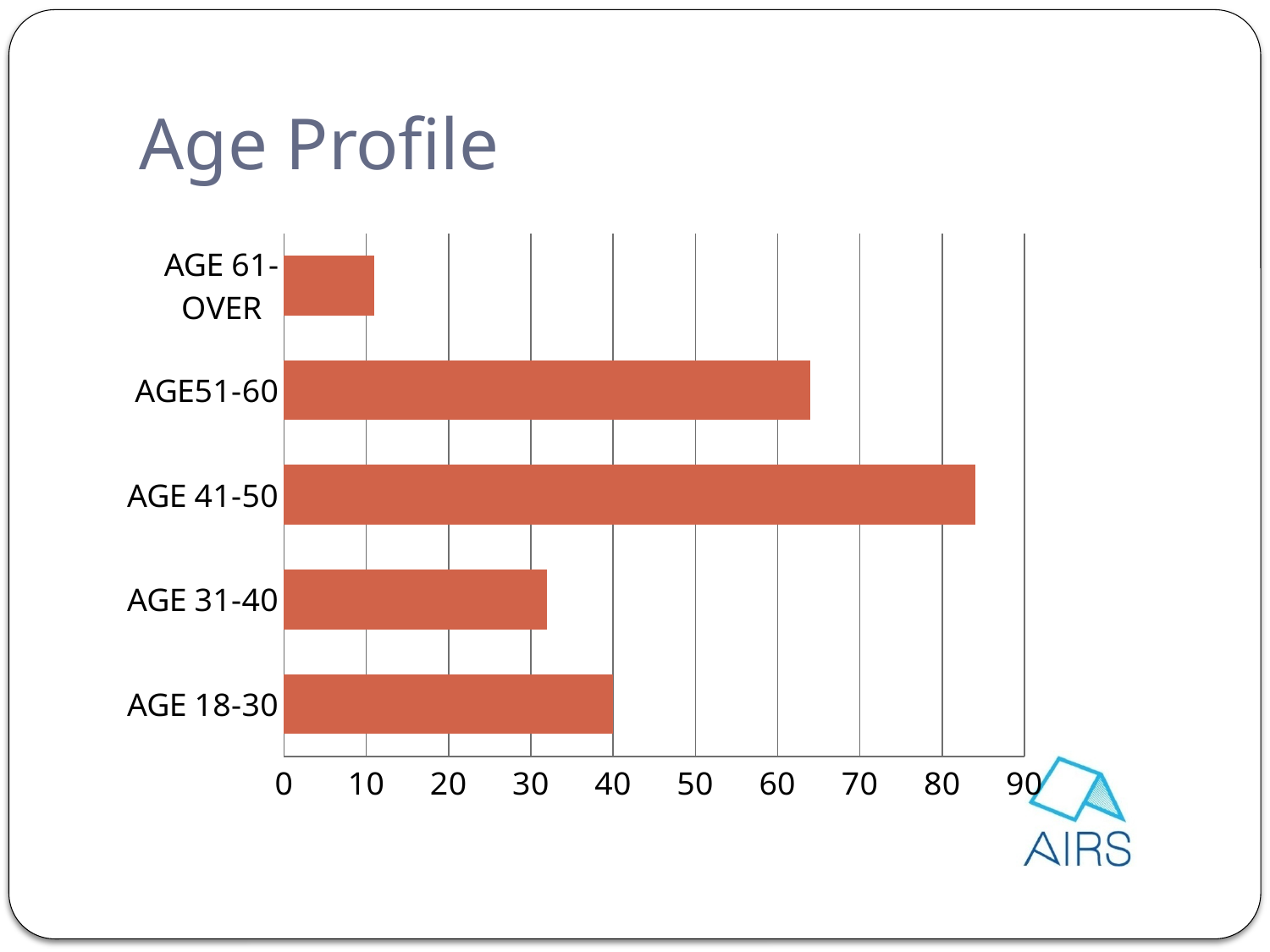
What is the title of the slide's chart? Age Profile Which age category has the highest value? AGE 41-50 Is the value for AGE 31-40 greater or less than 30? greater Is the value for AGE 41-50 greater or less than 80? greater Which has a larger value, AGE 31-40 or AGE 61-OVER? AGE 31-40 Is the value for AGE51-60 greater or less than 70? less What kind of chart is shown on the slide? bar chart Which has a larger value, AGE51-60 or AGE 18-30? AGE51-60 How many age categories are plotted in the chart? 5 Which age category has the lowest value? AGE 61-OVER